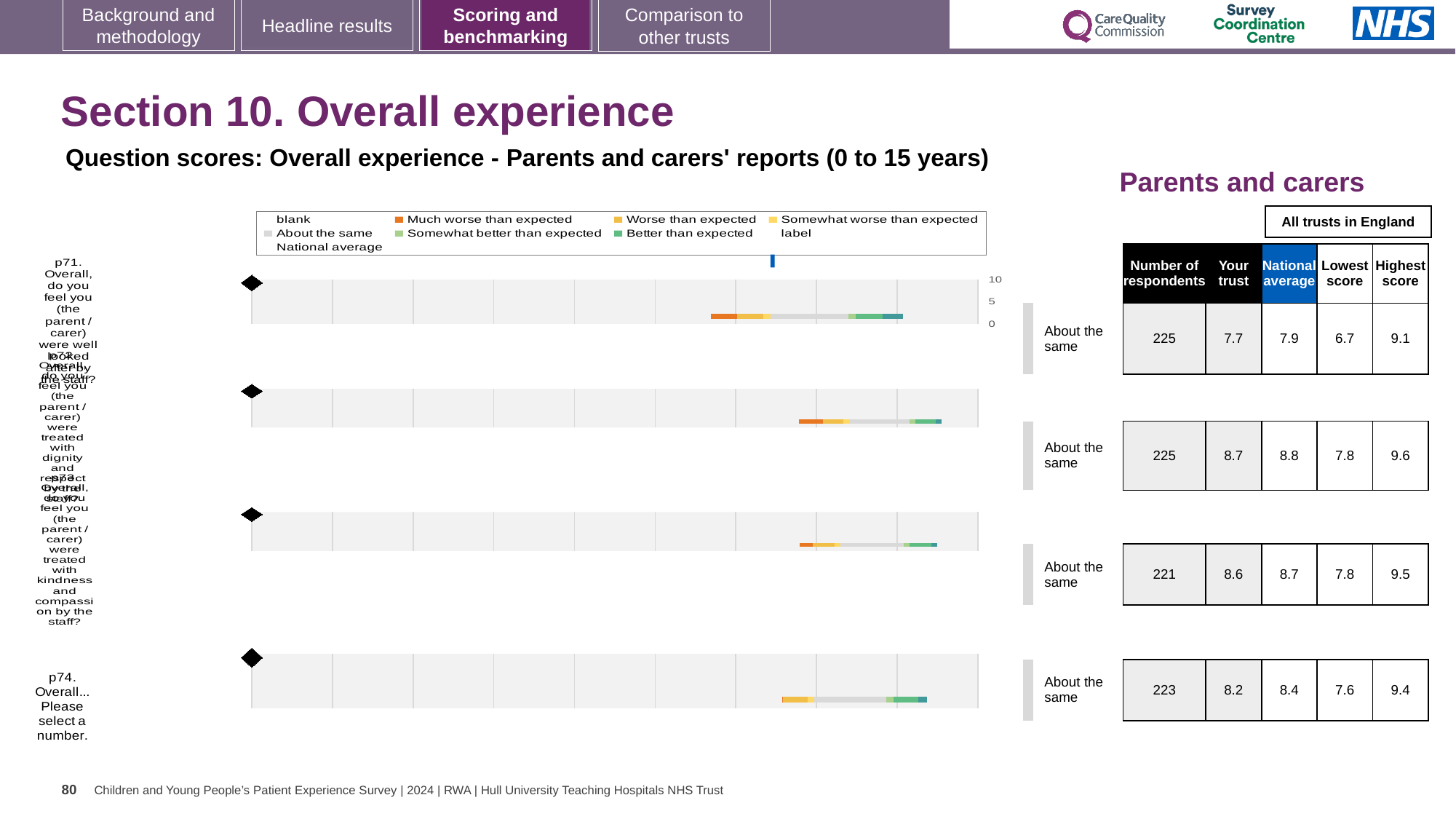
What heading appears above the Lowest score and Highest score columns of the table? All trusts in England In the table beside the charts, what is the national average for p74? 8.4 In the table beside the charts, how many respondents are listed for p71? 225 What kind of chart is used to show the question scores on this slide? bar chart How many entries does the chart legend list? 9 How many question rows (charts) are plotted on the slide? 4 Which row of the table has the highest 'Your trust' score? the second row (8.7) In the table beside the charts, what is the 'Your trust' score for p71? 7.7 For p71, is the 'Your trust' score higher or lower than the national average in the table? lower Which colour in the legend represents 'Much worse than expected'? orange What benchmark category is shown next to the chart for p74 (Overall... Please select a number)? About the same For p74, what is the difference between the highest score and the lowest score in the table? 1.8